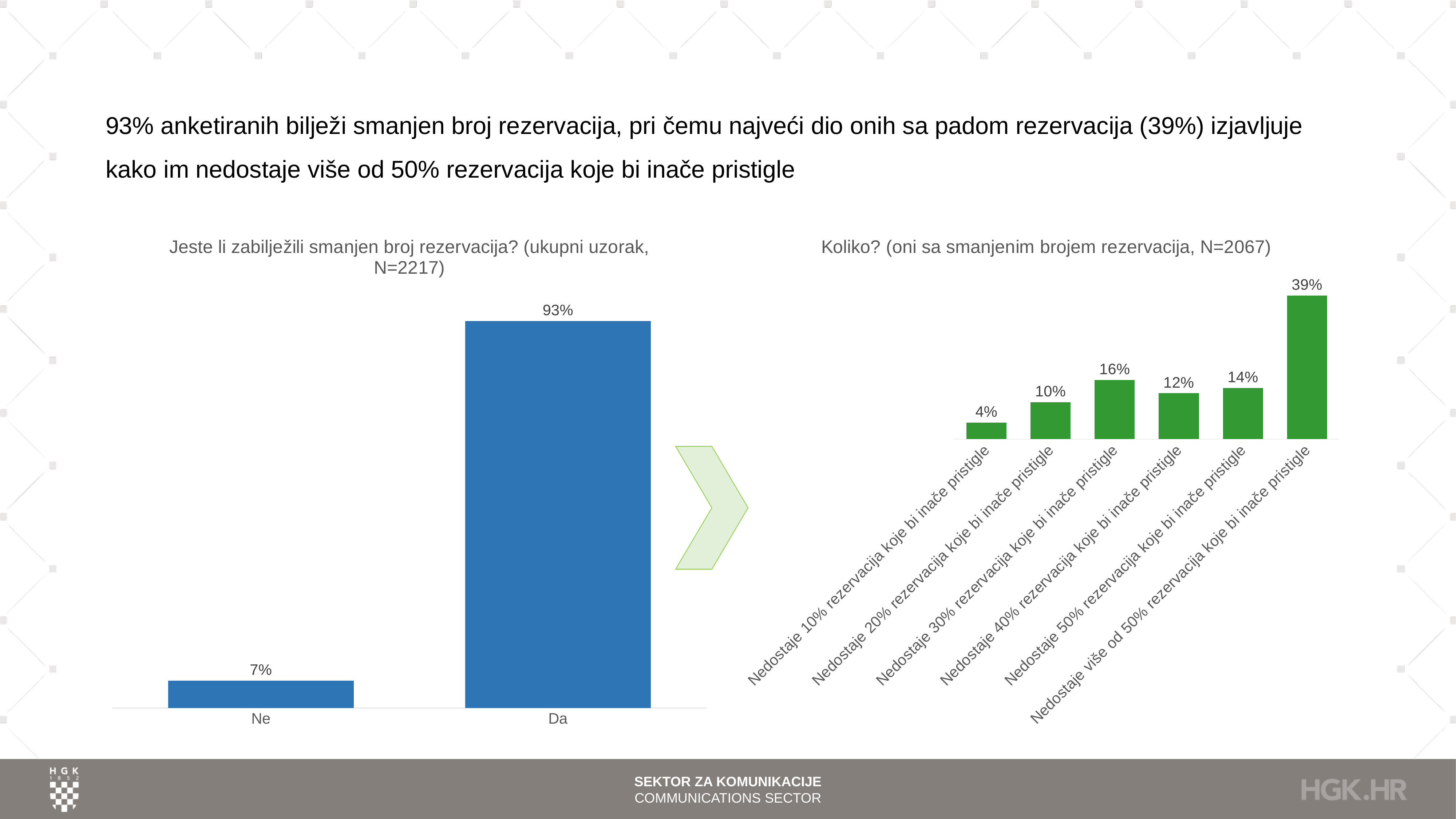
In the right chart ("Koliko?"), which is larger: the value for "Nedostaje 40% rezervacija koje bi inače pristigle" or "Nedostaje 50% rezervacija koje bi inače pristigle"? Nedostaje 50% rezervacija koje bi inače pristigle In the right chart ("Koliko?"), how many categories are shown? 6 In the right chart ("Koliko?"), what is the value for "Nedostaje 30% rezervacija koje bi inače pristigle"? 16% In the left chart ("Jeste li zabilježili smanjen broj rezervacija?"), how many categories are shown? 2 In the right chart ("Koliko?"), which category has the highest value? Nedostaje više od 50% rezervacija koje bi inače pristigle In the left chart ("Jeste li zabilježili smanjen broj rezervacija?"), what is the value for "Ne"? 7% In the right chart ("Koliko?"), which category has the lowest value? Nedostaje 10% rezervacija koje bi inače pristigle In the right chart ("Koliko?"), what is the value for "Nedostaje 10% rezervacija koje bi inače pristigle"? 4% In the right chart ("Koliko?"), what is the difference between the values for "Nedostaje više od 50% rezervacija koje bi inače pristigle" and "Nedostaje 50% rezervacija koje bi inače pristigle"? 25% In the left chart ("Jeste li zabilježili smanjen broj rezervacija?"), what is the value for "Da"? 93% In the left chart ("Jeste li zabilježili smanjen broj rezervacija?"), what is the difference between the values for "Da" and "Ne"? 86% What type of chart is the right chart ("Koliko?")? Bar chart